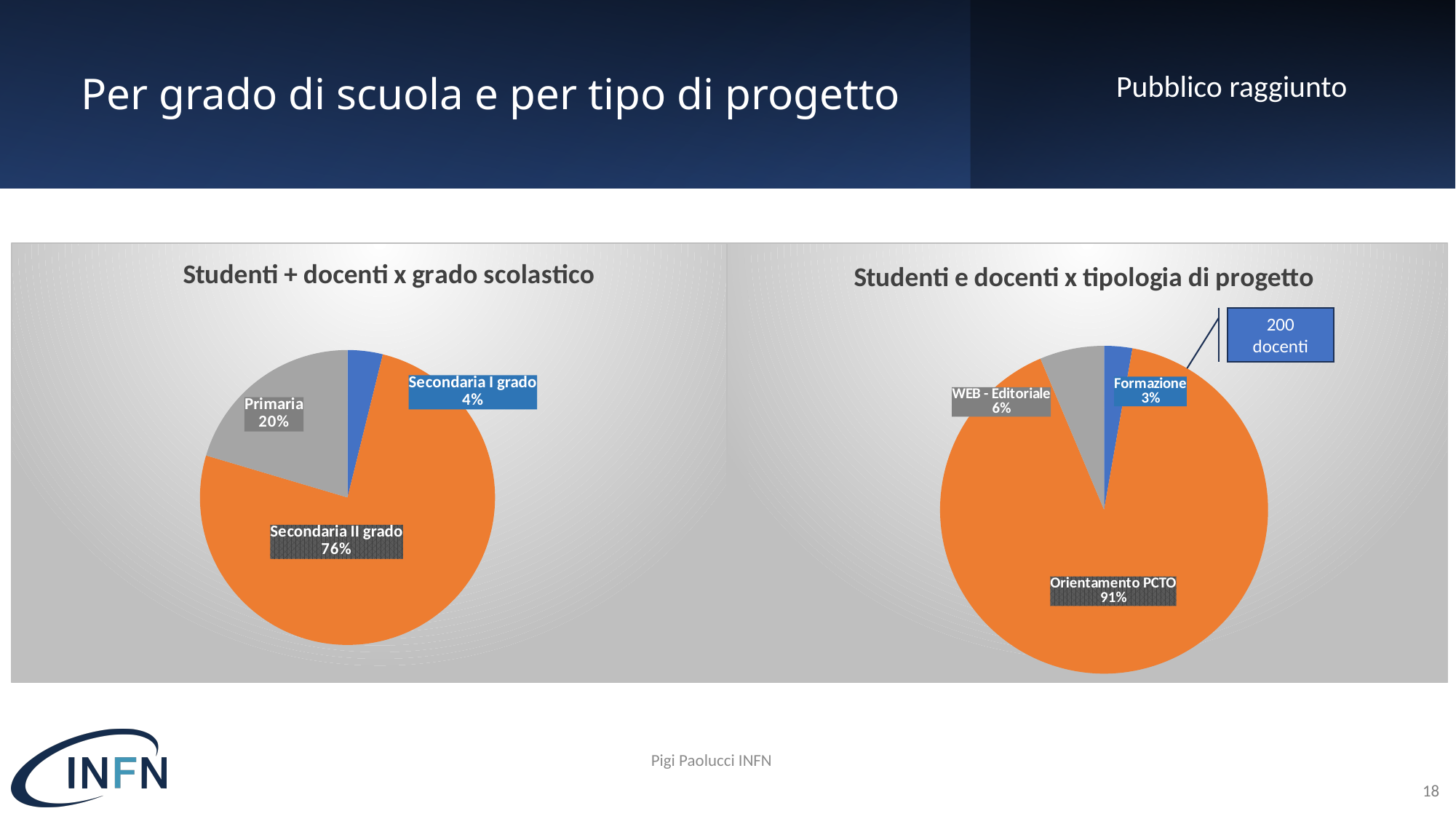
In the chart titled 'Studenti e docenti x tipologia di progetto', what share does Orientamento PCTO have? 91% In the chart titled 'Studenti + docenti x grado scolastico', what share does Secondaria I grado have? 4% In the chart titled 'Studenti + docenti x grado scolastico', which category has the largest slice? Secondaria II grado In the chart titled 'Studenti e docenti x tipologia di progetto', what share does Formazione have? 3% In the chart titled 'Studenti + docenti x grado scolastico', what is the difference in percentage points between Secondaria II grado and Primaria? 56 In the chart titled 'Studenti + docenti x grado scolastico', how many slices does the pie have? 3 In the chart titled 'Studenti e docenti x tipologia di progetto', which is larger, WEB - Editoriale or Formazione? WEB - Editoriale In the chart titled 'Studenti + docenti x grado scolastico', which category has the smallest slice? Secondaria I grado What kind of chart is the chart titled 'Studenti e docenti x tipologia di progetto'? Pie chart